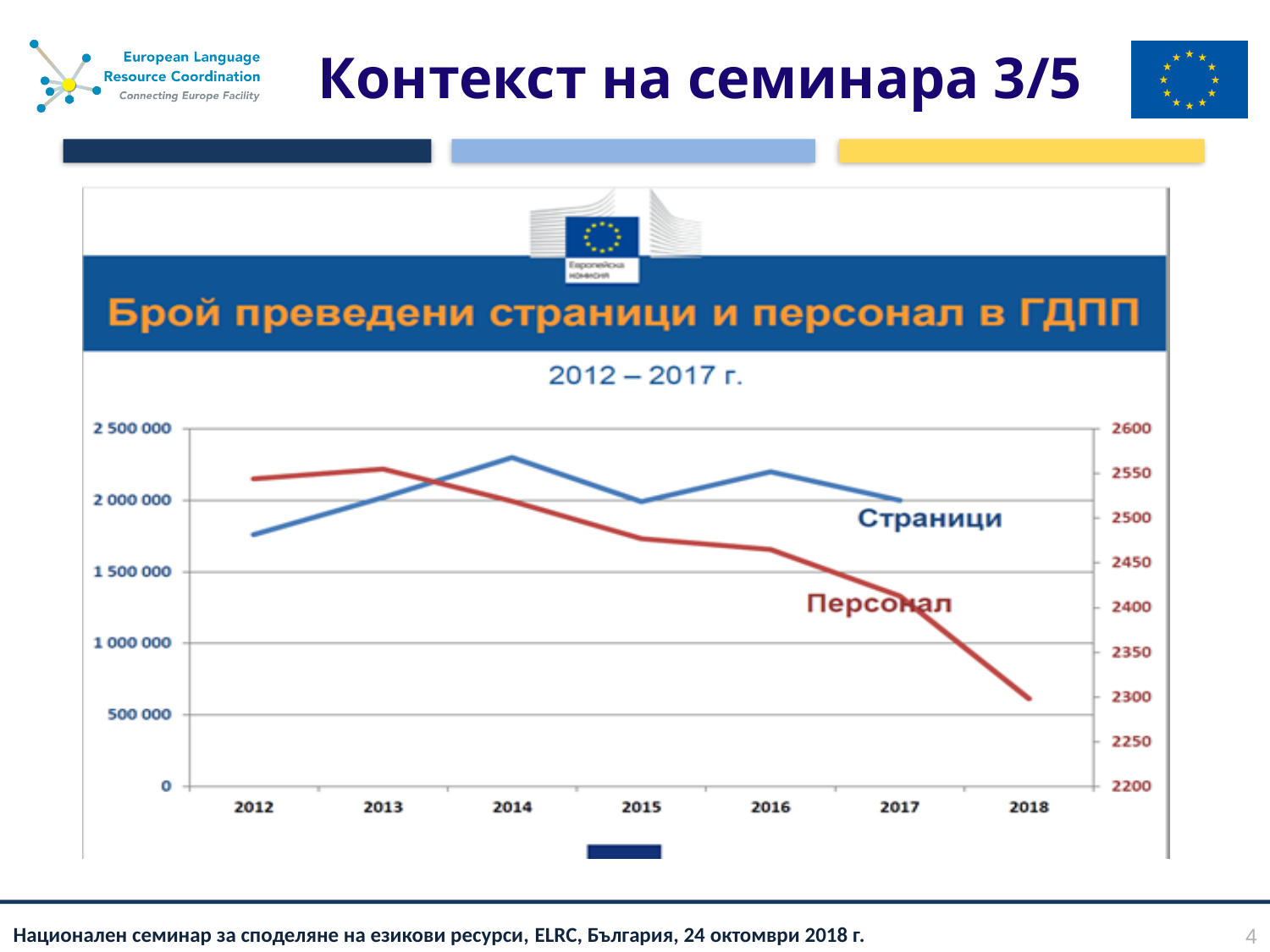
Is the value for Страници in 2012 greater or less than 2 000 000? less Which series is drawn in red on the chart? Персонал What kind of chart is shown on the slide? line chart How many years are labelled on the x axis of the chart? 7 Is the value for Персонал in 2018 greater or less than 2350? less Is the value for Страници in 2014 greater or less than 2 000 000? greater In which year does the Страници series reach its highest value? 2014 In which year is the Страници series at its lowest value? 2012 Does the Персонал series rise or fall from 2013 to 2018? fall How many series are plotted on the chart? 2 In which year is the Персонал series at its lowest value? 2018